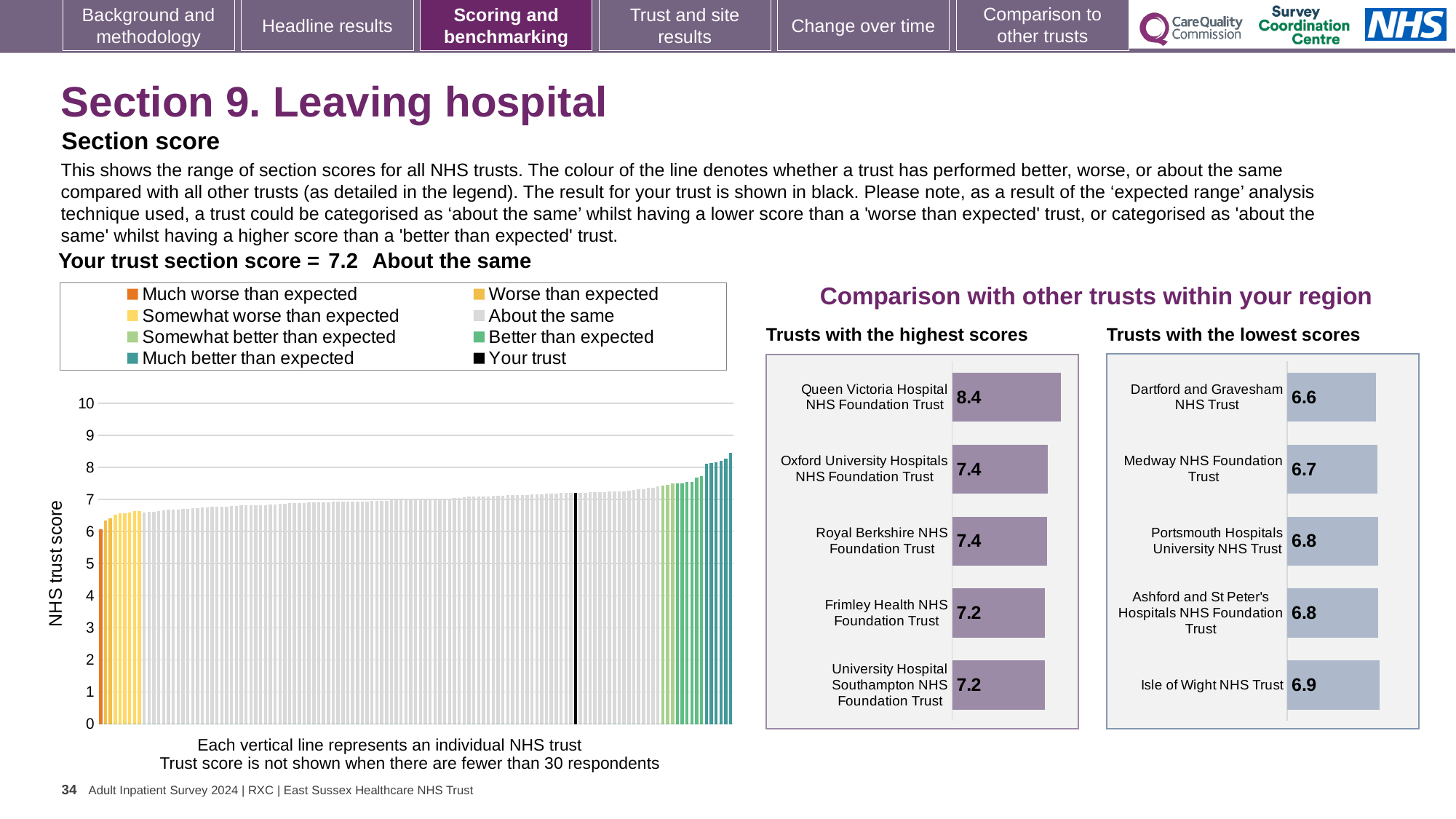
How many trusts are shown in the 'Trusts with the highest scores' chart? 5 In the 'Trusts with the lowest scores' chart, which trust has the lowest score? Dartford and Gravesham NHS Trust In the 'Trusts with the highest scores' chart, what is the difference between the scores of Queen Victoria Hospital NHS Foundation Trust and Oxford University Hospitals NHS Foundation Trust? 1.0 In the 'Trusts with the highest scores' chart, what is the score for Queen Victoria Hospital NHS Foundation Trust? 8.4 In the 'Trusts with the lowest scores' chart, what is the score for Medway NHS Foundation Trust? 6.7 In the 'Trusts with the lowest scores' chart, what is the difference between the scores of Isle of Wight NHS Trust and Dartford and Gravesham NHS Trust? 0.3 What kind of chart is the large chart on the left showing NHS trust scores? bar chart How many entries does the legend of the left-hand NHS trust score chart list? 8 In the 'Trusts with the highest scores' chart, which trust has the highest score? Queen Victoria Hospital NHS Foundation Trust In the left-hand NHS trust score chart, what is the section score for your trust (the black line)? 7.2 In the 'Trusts with the lowest scores' chart, which has the higher score: Portsmouth Hospitals University NHS Trust or Isle of Wight NHS Trust? Isle of Wight NHS Trust How many trusts are shown in the 'Trusts with the lowest scores' chart? 5